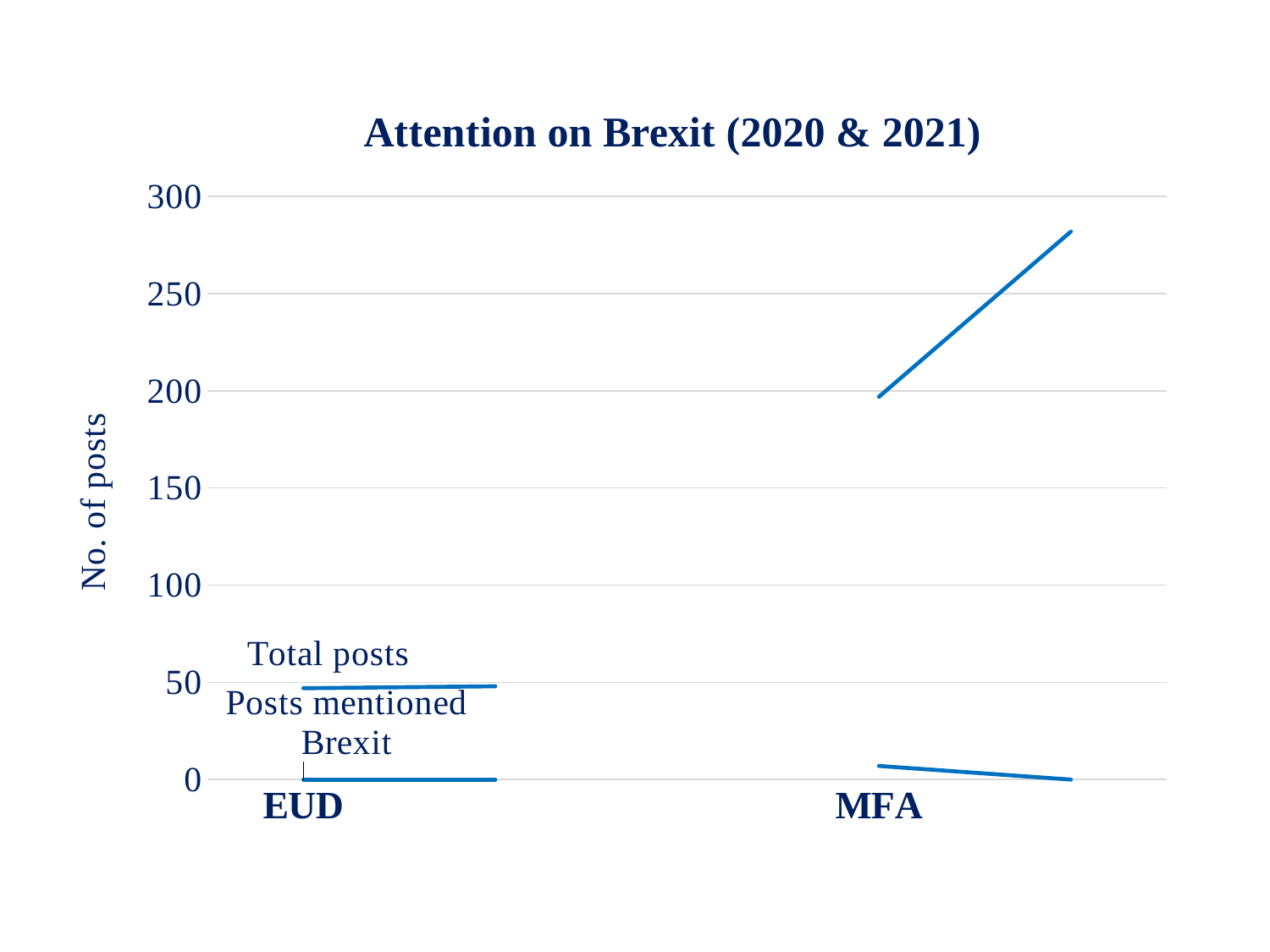
Is the value of Total posts for MFA greater or less than 150? greater What kind of chart is shown on the slide? line chart What is the label on the vertical axis of the chart? No. of posts What is the title of the chart? Attention on Brexit (2020 & 2021) Is the value of Total posts for EUD greater or less than 100? less Which category has the higher value for Total posts, EUD or MFA? MFA Is the value of Posts mentioned Brexit for EUD greater or less than 50? less How many categories are shown on the horizontal axis of the chart? 2 Which category has the highest value for Total posts? MFA Which category has the lowest value for Total posts? EUD